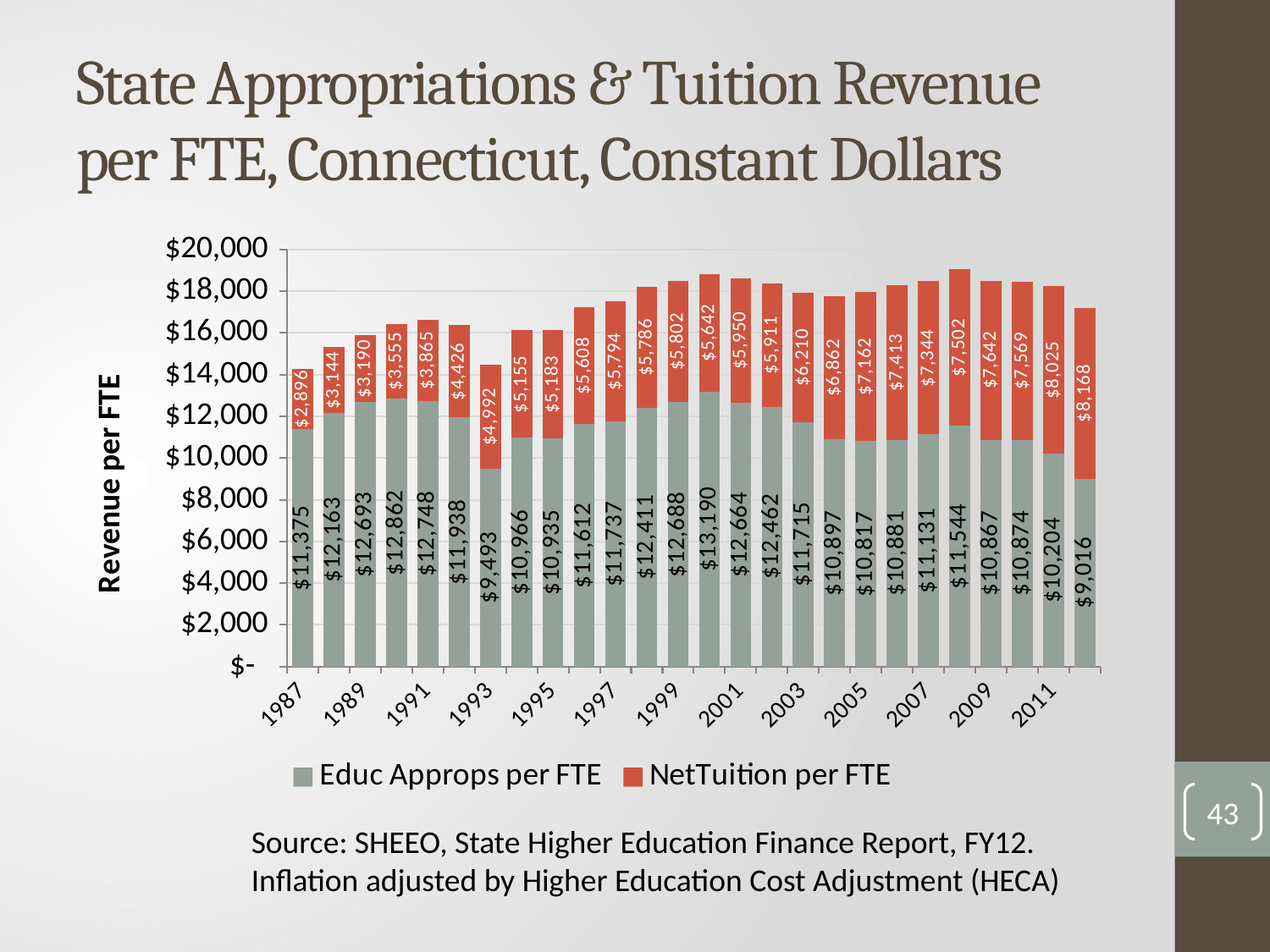
What is the Educ Approps per FTE value for 1993? $9,493 What is the highest Educ Approps per FTE value labeled on the chart? $13,190 How many bars (years) are plotted in the chart? 26 Does NetTuition per FTE generally rise or fall from 1987 to the last year shown? Rise What kind of chart is shown on the slide? Stacked bar chart What is the lowest NetTuition per FTE value shown, and in which year does it occur? $2,896 in 1987 What is the difference between Educ Approps per FTE in 1991 and in 1993? $3,255 What is the Educ Approps per FTE value for 1987? $11,375 How many series does the legend list? 2 What is the NetTuition per FTE value for 2011? $8,025 Which is larger: NetTuition per FTE in 2005 or in 1995? 2005 What is the total of the stacked bar for 1987 (Educ Approps plus NetTuition per FTE)? $14,271